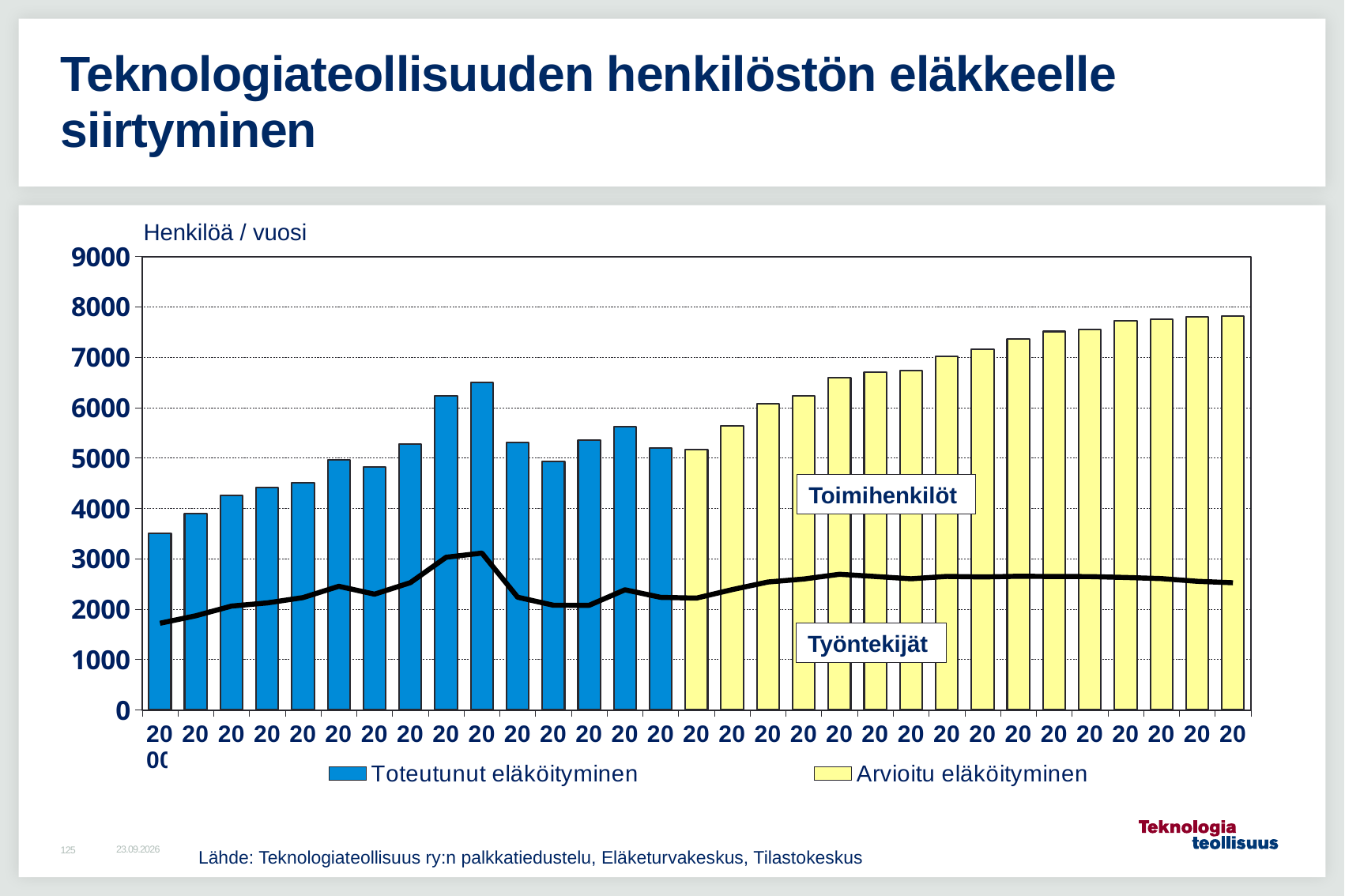
Is the value of the first (leftmost) bar greater or less than 3000? greater What is the label shown above the vertical axis? Henkilöä / vuosi Which is larger, the first bar on the left or the last bar on the right? The last bar on the right Which series is drawn in blue? Toteutunut eläköityminen Do the yellow (Arvioitu eläköityminen) bars rise or fall from left to right? Rise Is the value of the last (rightmost) bar greater or less than 8000? less Is the tallest blue (Toteutunut eläköityminen) bar greater or less than 6000? greater What are the two series named in the legend? Toteutunut eläköityminen and Arvioitu eläköityminen How many series does the legend list? 2 What kind of chart is shown on the slide? Bar chart (with a line)